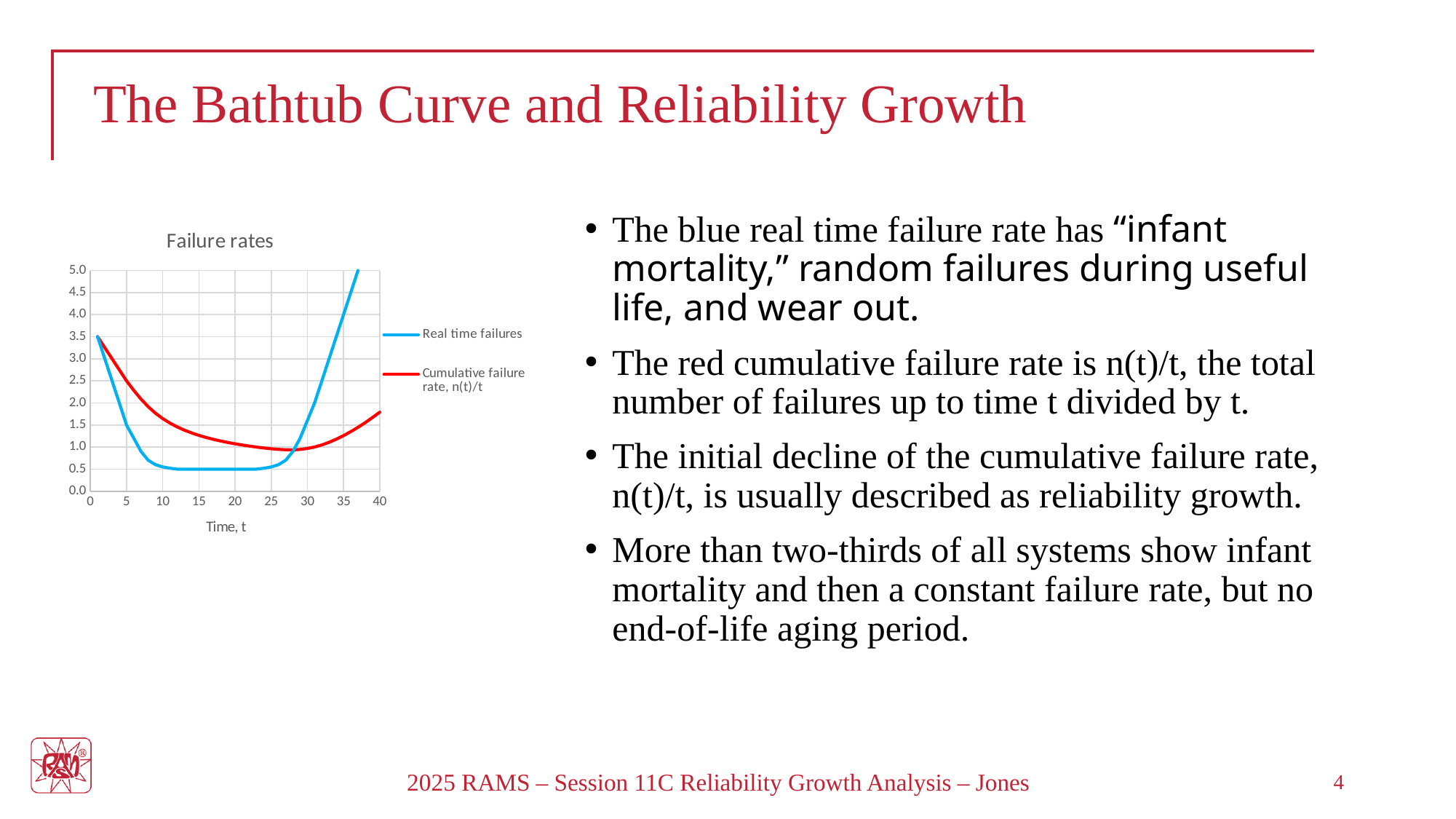
What is the label of the chart's x axis? Time, t Is the value of Cumulative failure rate, n(t)/t at time 15 greater or less than 1.0? greater Is the value of Cumulative failure rate, n(t)/t at time 5 greater or less than 2.0? greater What is the title of the chart? Failure rates Is the value of Cumulative failure rate, n(t)/t at time 30 greater or less than 1.5? less How many series does the chart's legend list? 2 At time 15, which series has the larger value, Real time failures or Cumulative failure rate, n(t)/t? Cumulative failure rate, n(t)/t At time 35, which series has the larger value, Real time failures or Cumulative failure rate, n(t)/t? Real time failures What kind of chart is shown on the slide? line chart Does the Real time failures series rise or fall between time 0 and time 10? fall